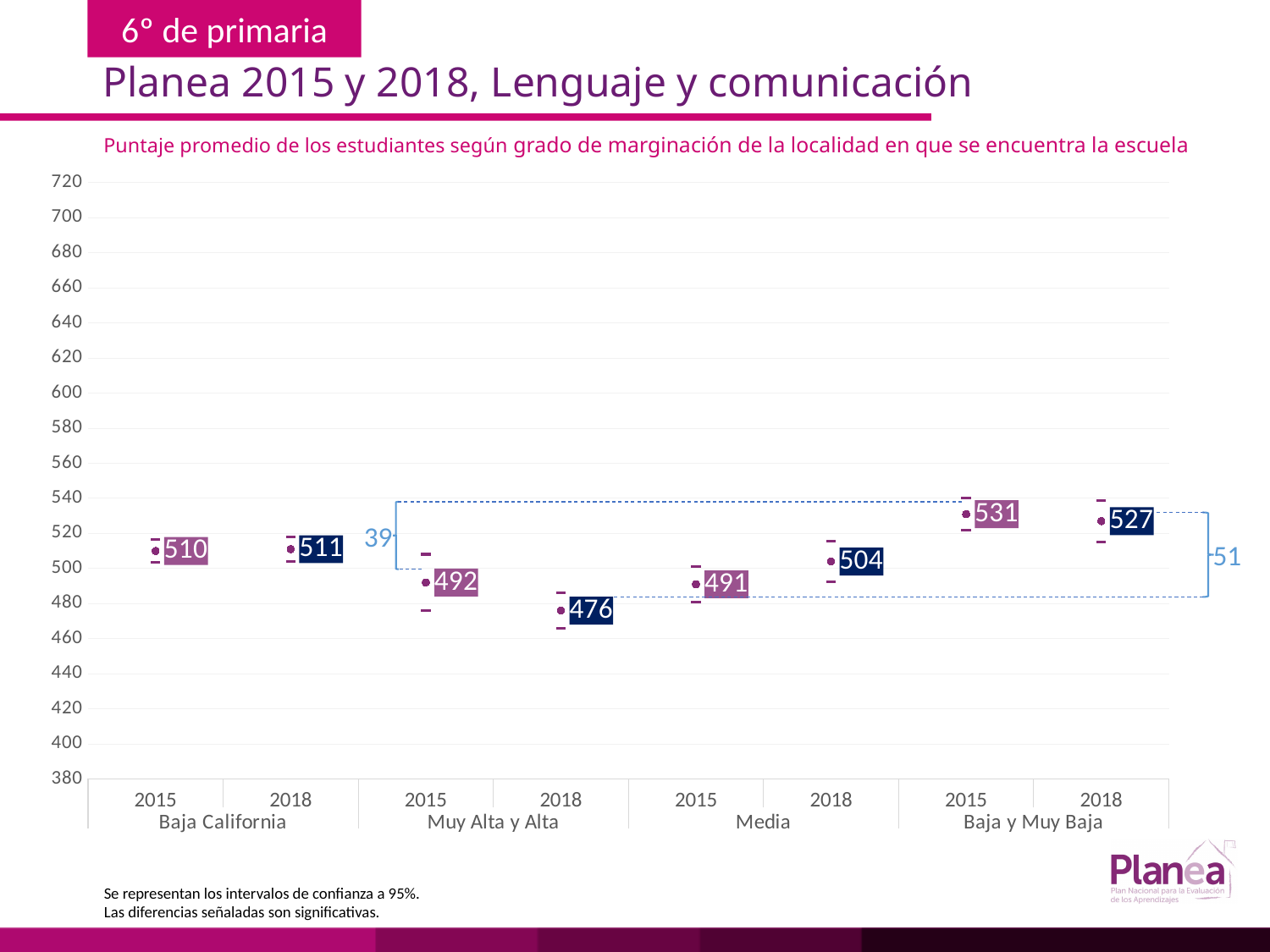
Which group and year has the highest average score? Baja y Muy Baja, 2015 What is the difference between the 2018 scores of the Media group and the Muy Alta y Alta group? 28 What is the average score for Baja California in 2015? 510 What is the average score for the Media group in 2018? 504 What is the average score for the Muy Alta y Alta marginación group in 2018? 476 Did the score for the Media group rise or fall from 2015 to 2018? Rise What is the average score for the Baja y Muy Baja group in 2015? 531 Which group and year has the lowest average score? Muy Alta y Alta, 2018 Which is larger, the 2018 score for Media or the 2018 score for Muy Alta y Alta? Media What is the difference between the 2015 and 2018 scores for the Muy Alta y Alta group? 16 How many data points are plotted on the chart? 8 What is the subtitle of the chart? Puntaje promedio de los estudiantes según grado de marginación de la localidad en que se encuentra la escuela